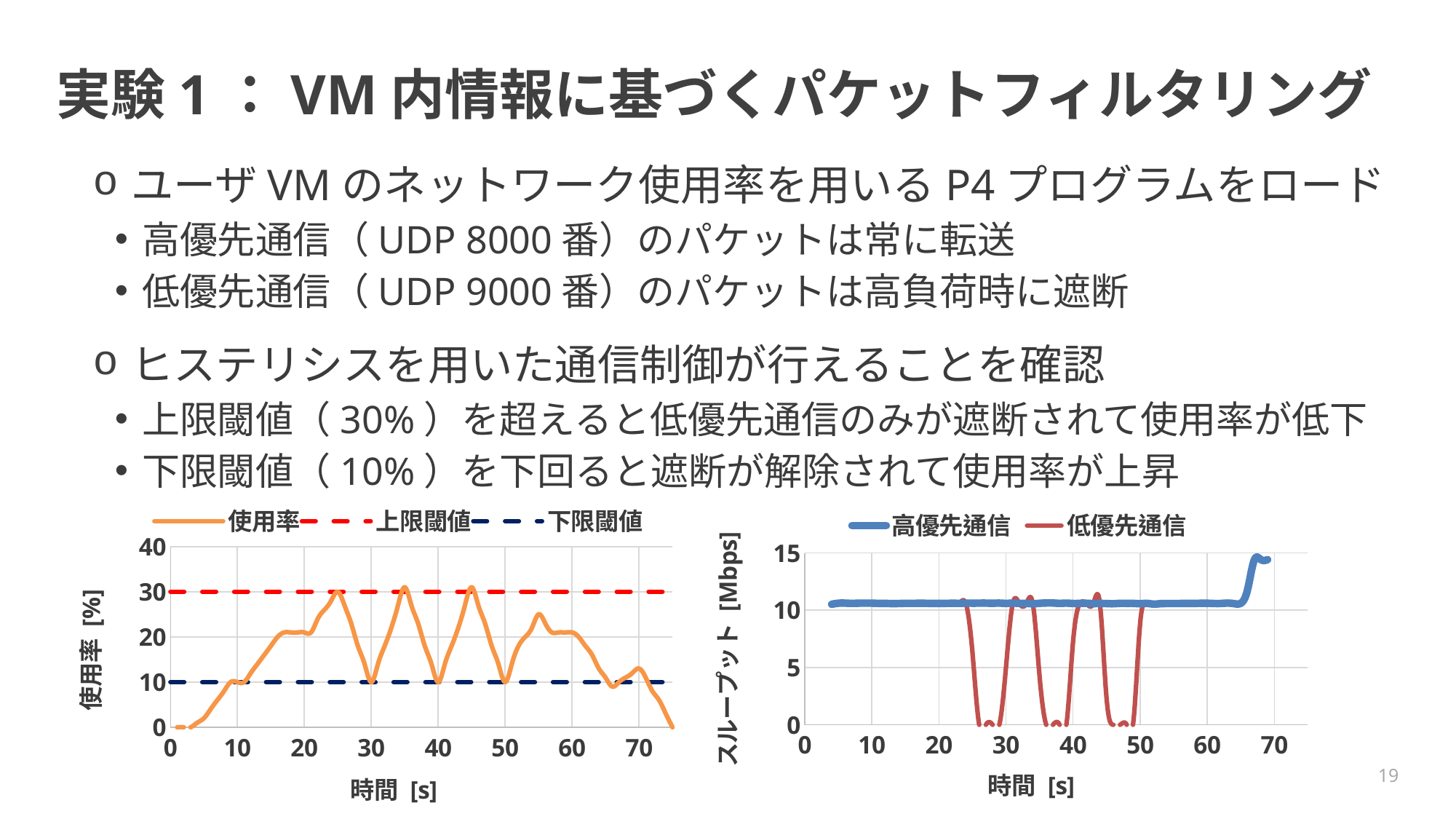
What kind of chart is the left chart (使用率 vs 時間)? line chart What is the y-axis label of the right chart? スループット [Mbps] How many series does the legend of the left chart list? 3 How many series does the legend of the right chart (スループット) list? 2 In the right chart, is the value of 低優先通信 at time 27 greater or less than 5? less In the right chart, which series has the larger value at time 45, 高優先通信 or 低優先通信? 高優先通信 In the left chart, at what value is the 下限閾値 line drawn? 10 In the right chart, is the value of 高優先通信 at time 60 greater or less than 5? greater In the left chart, at what value is the 上限閾値 line drawn? 30 In the left chart, is the value of 使用率 at time 5 greater or less than 10? less What is the y-axis label of the left chart? 使用率 [%]